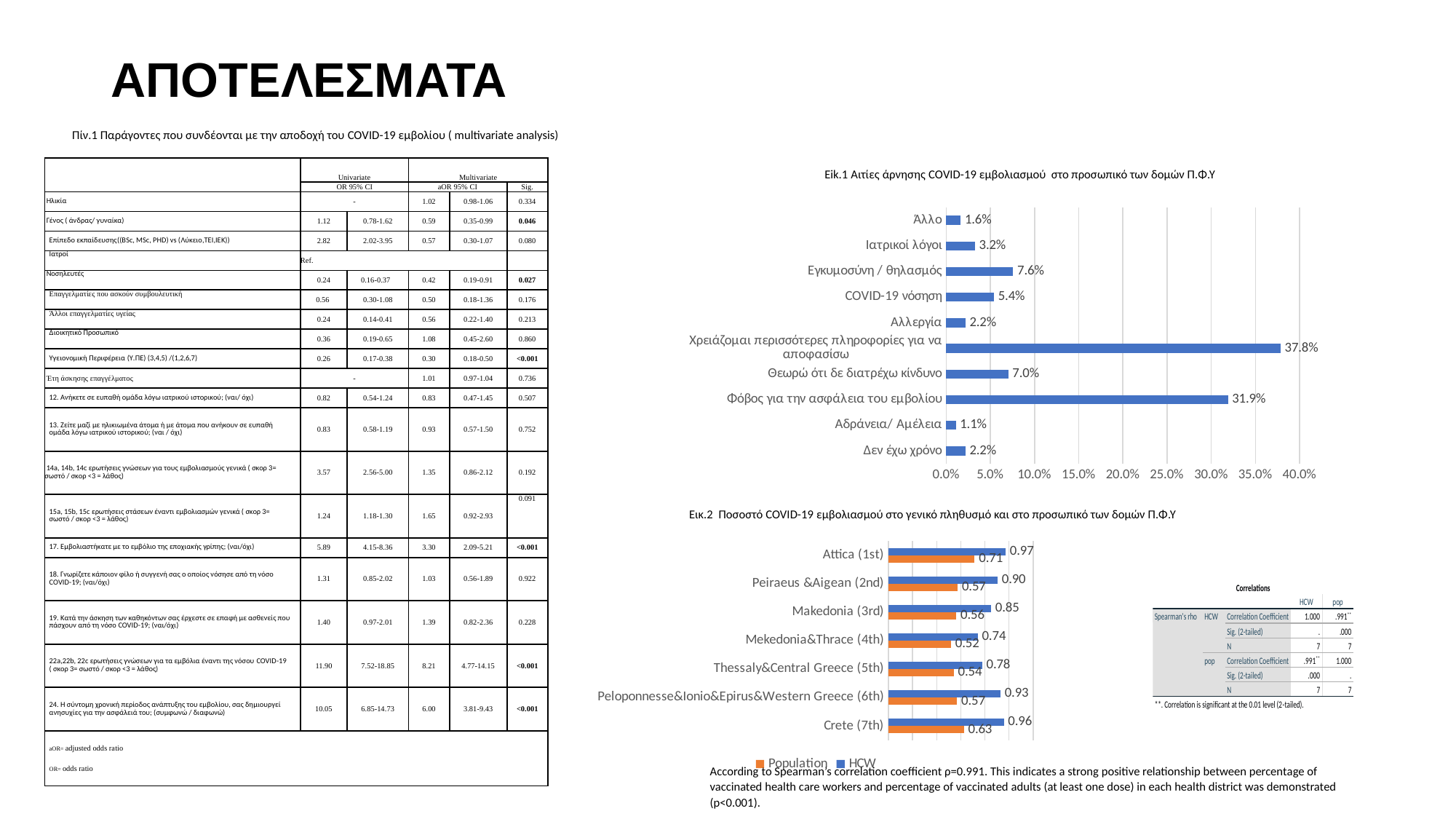
In the chart Εικ.2, what is the difference between the HCW and Population values for Peiraeus &Aigean (2nd)? 0.33 What type of chart is Εικ.1? Bar chart In the chart Εικ.2 (Ποσοστό COVID-19 εμβολιασμού), what is the HCW value for Attica (1st)? 0.97 In the chart Εικ.1, which reason has the lowest percentage? Αδράνεια/ Αμέλεια In the chart Εικ.2, which health district has the lowest HCW value? Mekedonia&Thrace (4th) How many reasons (categories) are shown in the chart Εικ.1? 10 In the chart Εικ.2, what is the Population value for Crete (7th)? 0.63 In the chart Εικ.1 (Αιτίες άρνησης COVID-19 εμβολιασμού), what is the value for 'Φόβος για την ασφάλεια του εμβολίου'? 31.9% In the chart Εικ.1, which reason has the highest percentage? Χρειάζομαι περισσότερες πληροφορίες για να αποφασίσω How many series does the legend of the chart Εικ.2 list? 2 In the chart Εικ.1, which is larger: 'Εγκυμοσύνη / θηλασμός' or 'COVID-19 νόσηση'? Εγκυμοσύνη / θηλασμός In the chart Εικ.1, what is the difference between 'Χρειάζομαι περισσότερες πληροφορίες για να αποφασίσω' and 'Φόβος για την ασφάλεια του εμβολίου'? 5.9%